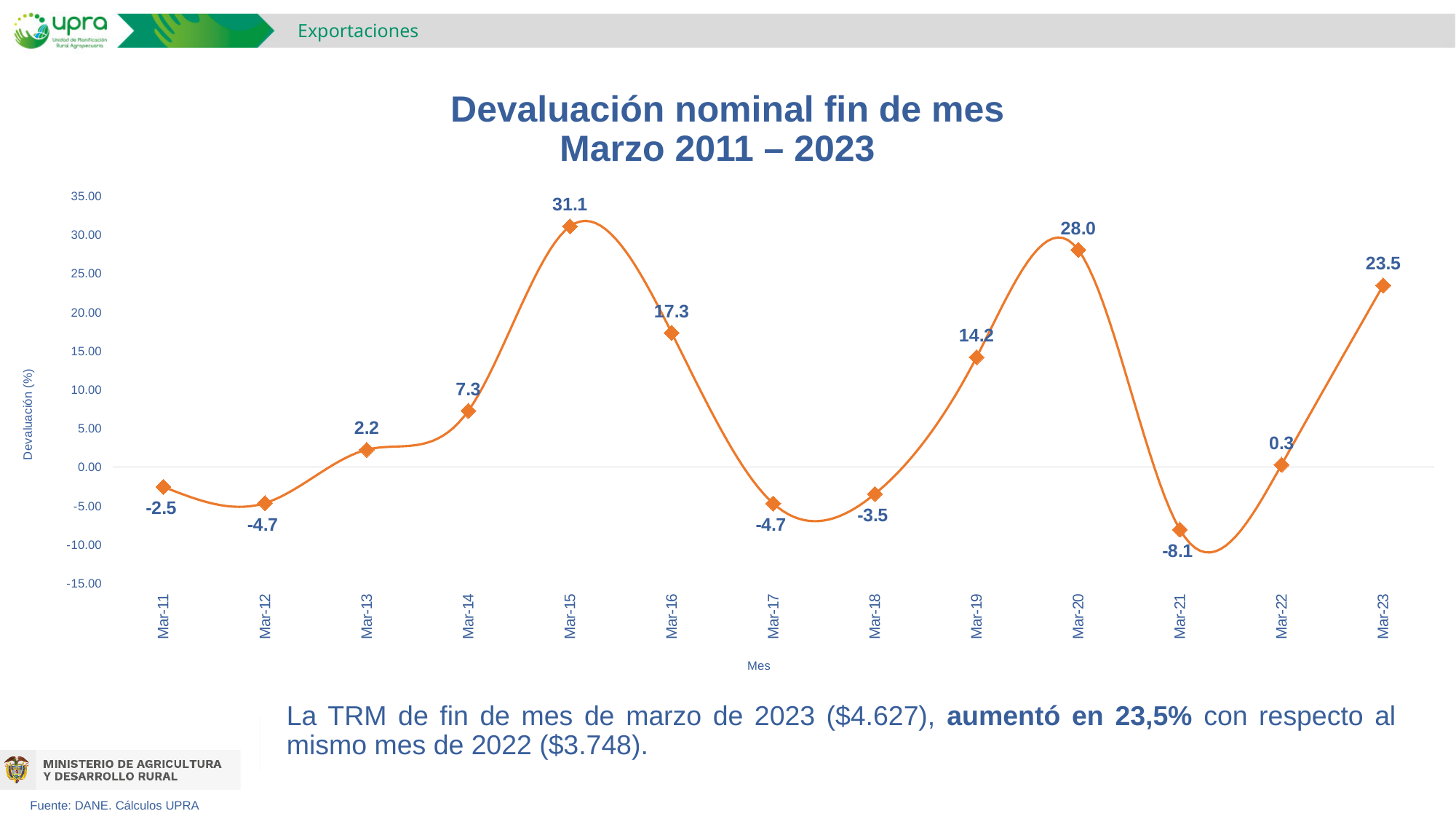
Which month has the highest value? Mar-15 Do the values rise or fall from Mar-21 to Mar-23? rise What is the difference between the values for Mar-20 and Mar-19? 13.8 Which month has the lowest value? Mar-21 Is the value for Mar-14 greater or less than 5.00? greater How many data points are plotted on the chart? 13 What is the value for Mar-15? 31.1 What is the value for Mar-21? -8.1 What is the label of the y axis? Devaluación (%) What kind of chart is shown on the slide? line chart What is the value for Mar-23? 23.5 Which is larger, the value for Mar-16 or the value for Mar-19? Mar-16